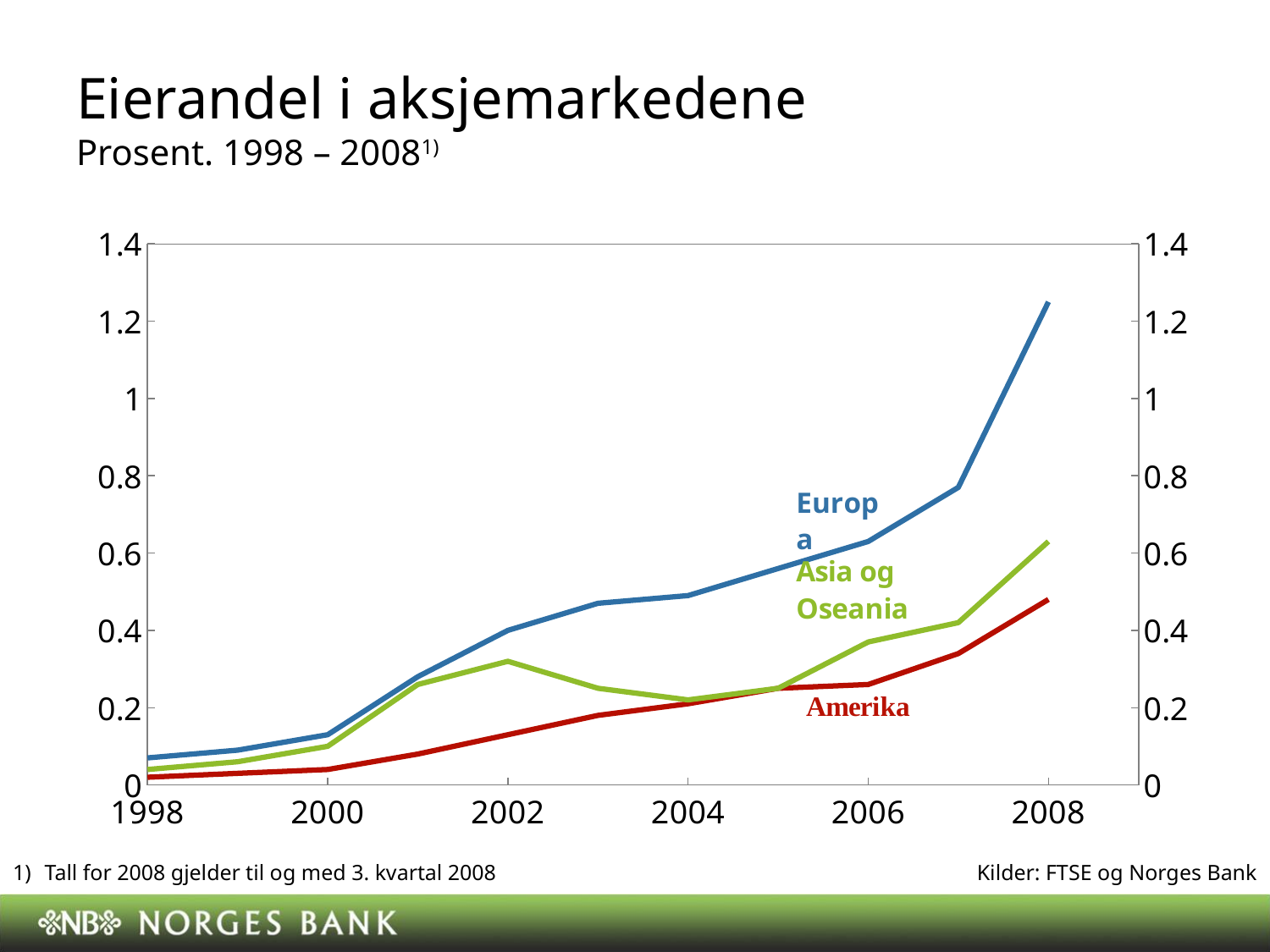
Does the Europa series rise or fall from 1998 to 2008? rise Is the value for Europa in 2008 greater or less than 1? greater Is the value for Amerika in 2008 greater or less than 0.6? less How many series are plotted on the chart? 3 What colour is the Amerika line? red What kind of chart is shown on the slide? line chart Which series has the highest value in 2008? Europa Which is larger in 2006, Asia og Oseania or Amerika? Asia og Oseania Is the value for Europa in 2004 greater or less than 0.6? less What is the title of the chart? Eierandel i aksjemarkedene Which series has the lowest value in 2008? Amerika